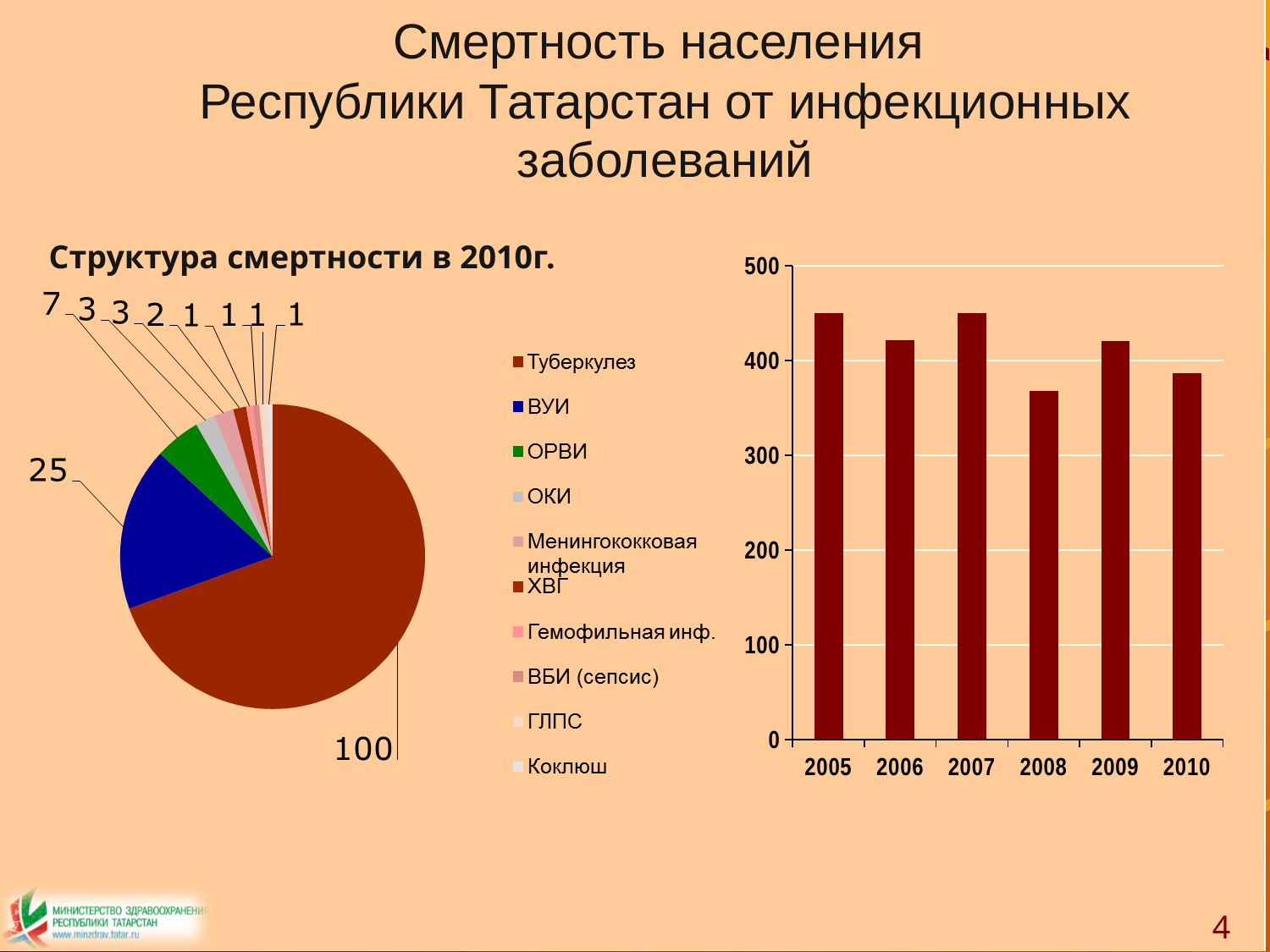
What kind of chart is the chart on the left titled 'Структура смертности в 2010г.'? pie chart How many entries does the legend of the pie chart 'Структура смертности в 2010г.' list? 10 In the bar chart on the right, is the value for 2008 greater or less than 400? less In the pie chart 'Структура смертности в 2010г.', what is the value for ОРВИ? 7 What kind of chart is the chart on the right side of the slide? bar chart In the bar chart on the right, which is larger, the value for 2008 or the value for 2009? 2009 In the pie chart 'Структура смертности в 2010г.', what is the value for ВУИ? 25 How many years are shown on the x axis of the bar chart on the right? 6 In the pie chart 'Структура смертности в 2010г.', which category has the largest slice? Туберкулез In the bar chart on the right, which year has the lowest value? 2008 In the pie chart 'Структура смертности в 2010г.', what is the value for Туберкулез? 100 In the pie chart 'Структура смертности в 2010г.', what is the difference between the values for Туберкулез and ВУИ? 75